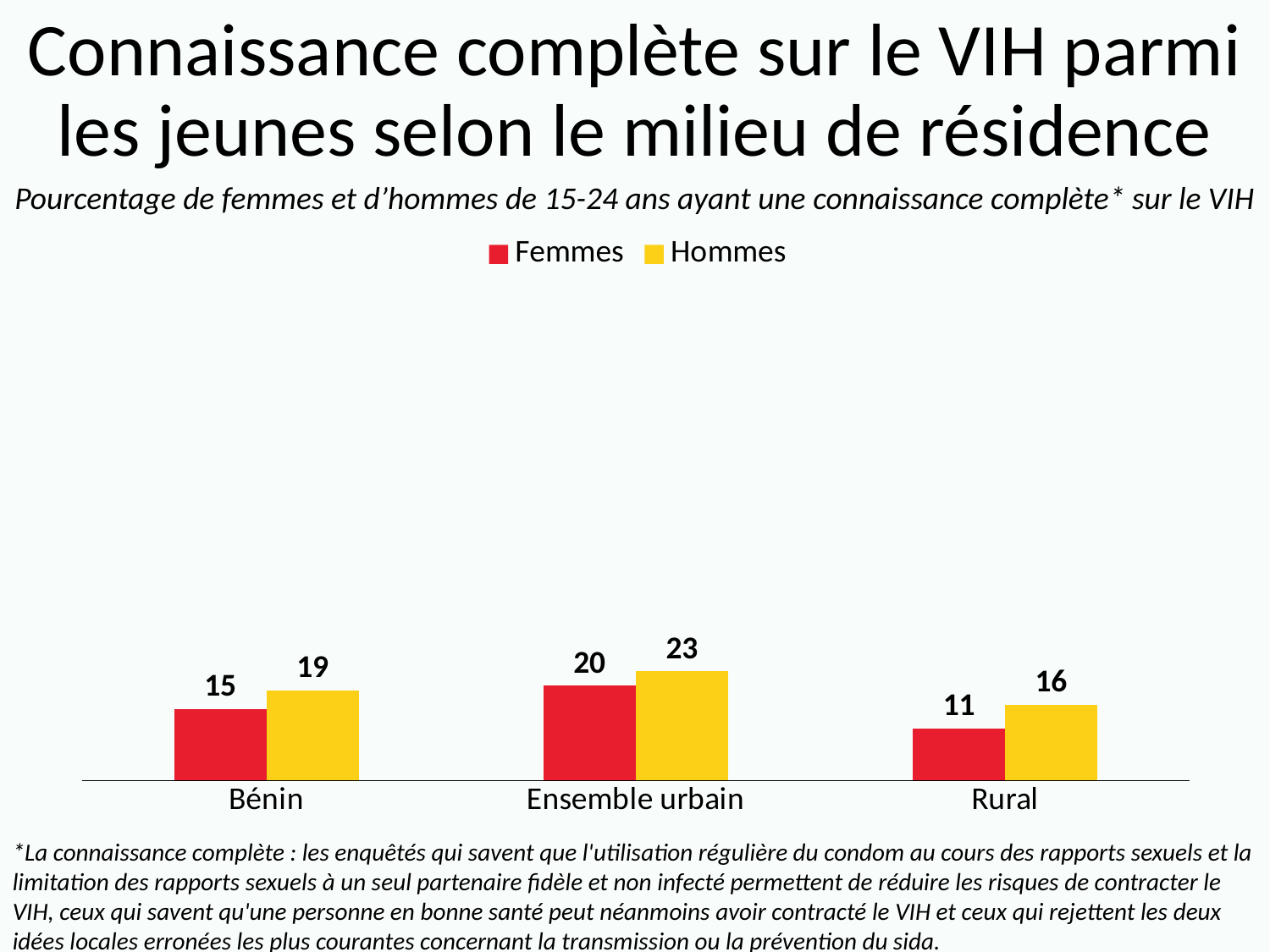
How many categories are shown on the x axis? 3 What is the value for Hommes in Rural? 16 What is the value for Hommes in Ensemble urbain? 23 What kind of chart is shown on the slide? Bar chart How many series does the legend list? 2 What is the difference between the Hommes and Femmes values in Rural? 5 What is the value for Femmes in Bénin? 15 Which category has the lowest value for Femmes? Rural What is the difference between the Femmes values for Ensemble urbain and Bénin? 5 Which is larger in Bénin, the value for Femmes or for Hommes? Hommes What is the value for Femmes in Rural? 11 Which category has the highest value for Hommes? Ensemble urbain